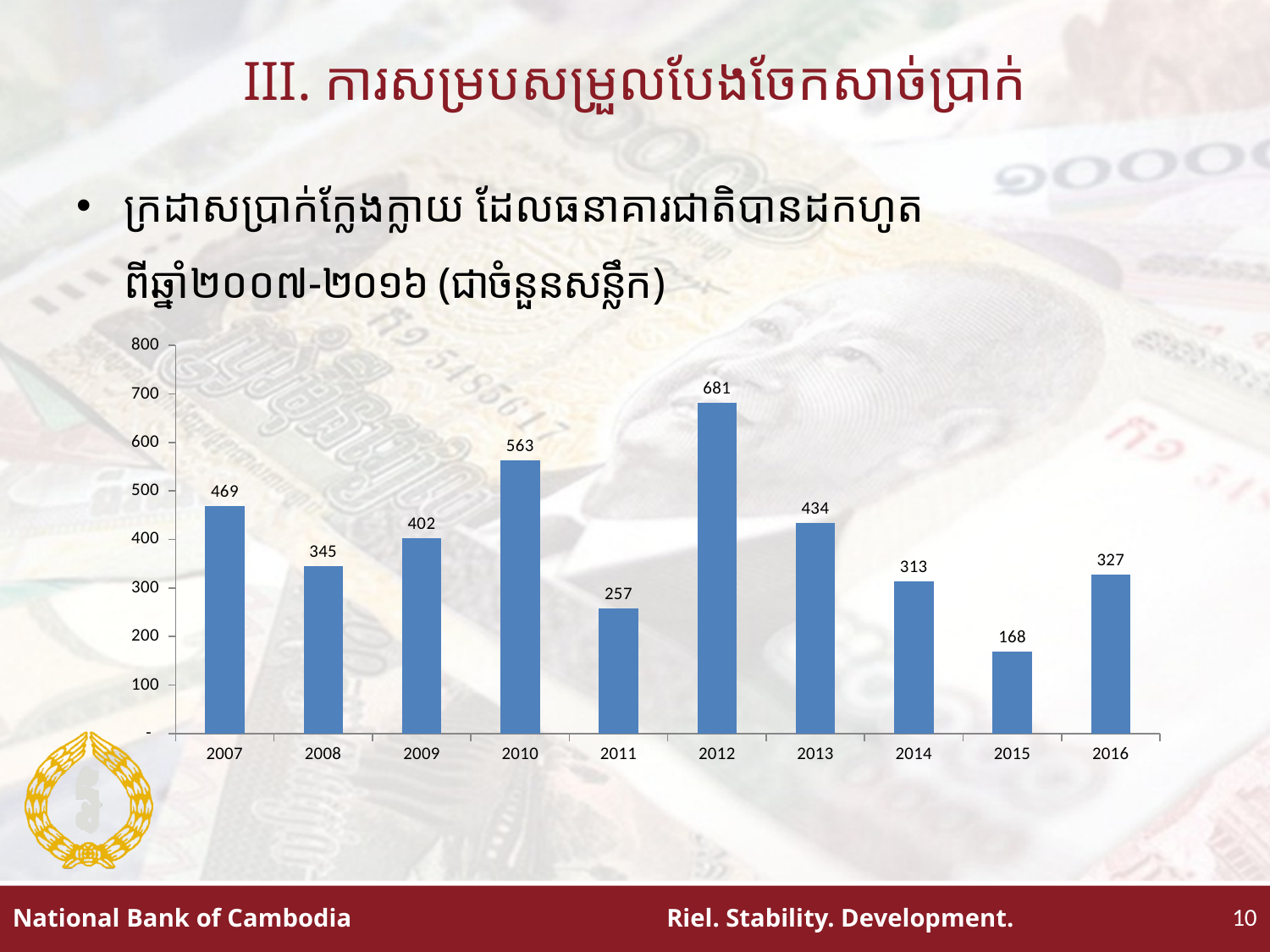
Do the values rise or fall from 2012 to 2015? fall What is the value for 2015? 168 Which year has the highest value? 2012 What is the value for 2007? 469 What kind of chart is shown on the slide? bar chart How many years are shown on the x axis? 10 What is the difference between the values for 2010 and 2009? 161 Which year has the lowest value? 2015 What is the difference between the values for 2012 and 2011? 424 Which is larger, the value for 2013 or the value for 2014? 2013 What is the value for 2012? 681 Is the value for 2016 greater or less than 300? greater